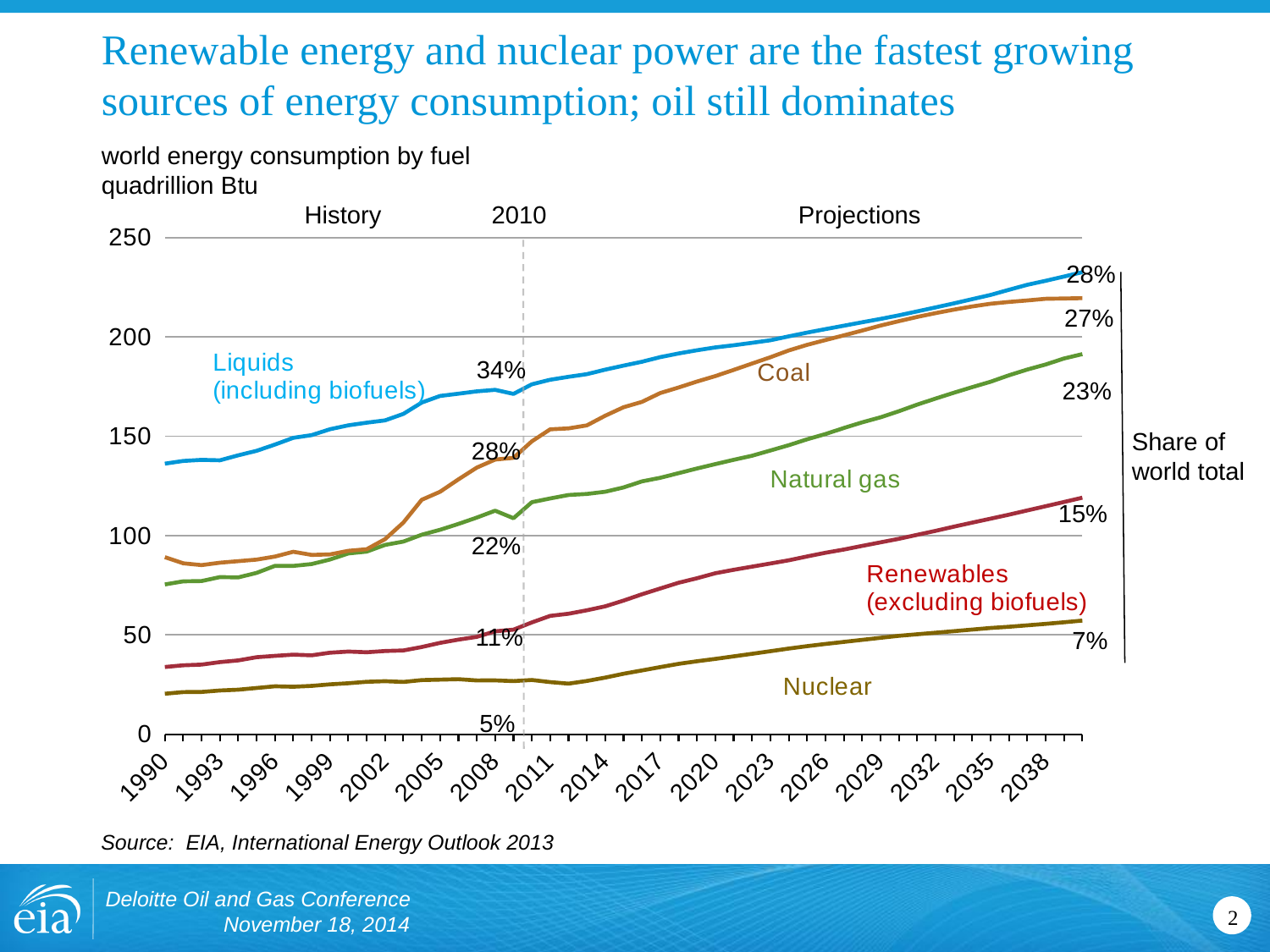
Which fuel has the lowest consumption throughout the chart? Nuclear What share of world total does Nuclear have in 2010? 5% What share of world total does Liquids (including biofuels) have in 2010? 34% How many fuel series are plotted on the chart? 5 What kind of chart is shown on the slide? line chart What share of world total is shown for Coal at the end of the projection period? 27% Which fuel has the highest consumption at the end of the projection period? Liquids (including biofuels) What share of world total is shown for Renewables (excluding biofuels) at the end of the projection period? 15% What share of world total is shown for Natural gas in 2010? 22% Is the value for Natural gas in 1990 greater or less than 100? less Does the Renewables (excluding biofuels) line rise or fall from 1990 to 2040? rise Is the value for Coal in 2038 greater or less than 200? greater